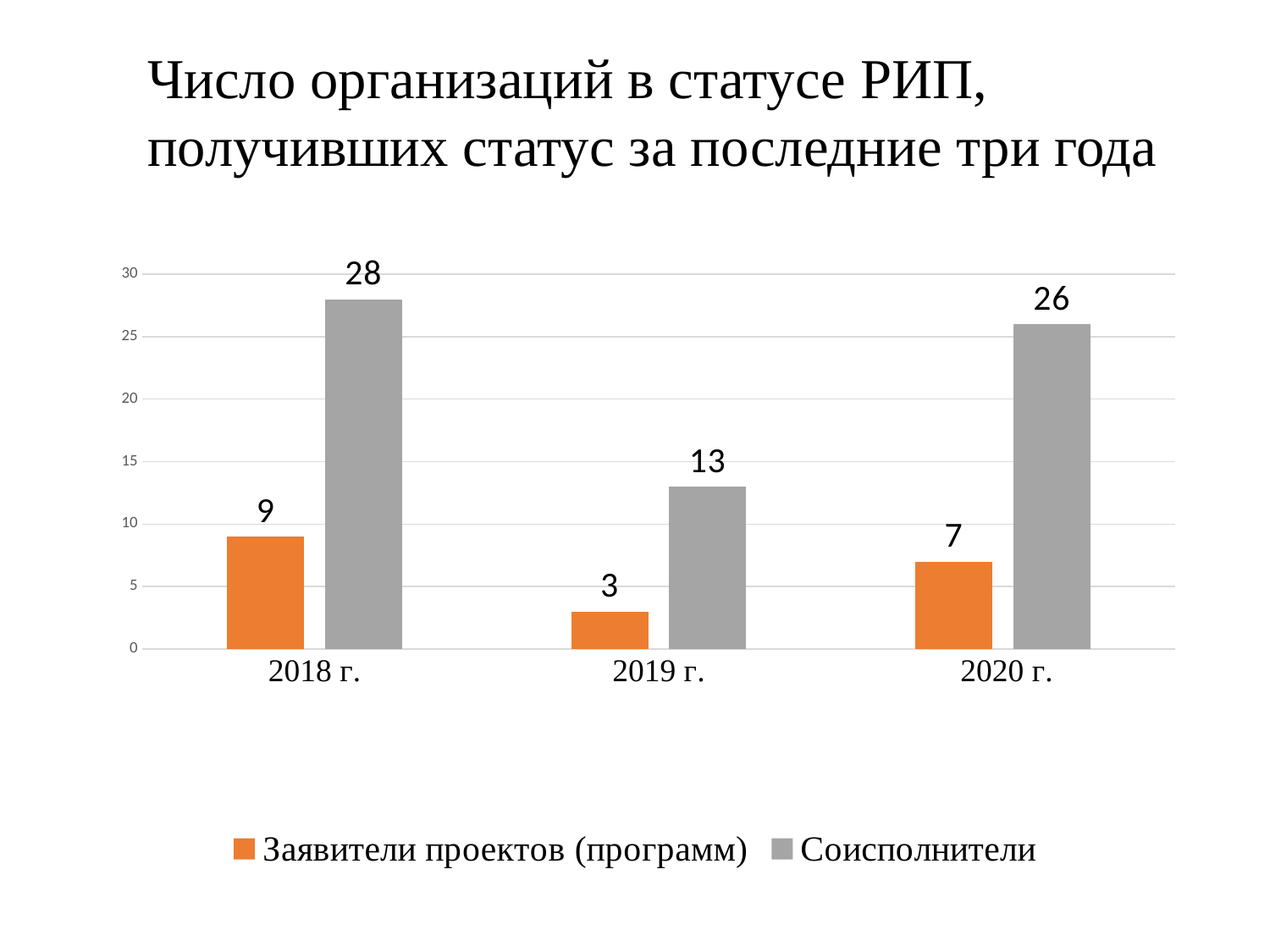
How many series does the legend list? 2 What kind of chart is shown on the slide? bar chart Which colour represents Соисполнители in the chart? grey Is the value for Соисполнители in 2019 г. greater or less than 15? less In which year is the value for Заявители проектов (программ) lowest? 2019 г. Which is larger: Заявители проектов (программ) in 2018 г. or Заявители проектов (программ) in 2020 г.? 2018 г. What is the value for Заявители проектов (программ) in 2018 г.? 9 How many years are shown on the x axis? 3 In which year is the value for Соисполнители highest? 2018 г. What is the value for Соисполнители in 2019 г.? 13 What is the value for Соисполнители in 2020 г.? 26 What is the difference between Соисполнители and Заявители проектов (программ) in 2020 г.? 19